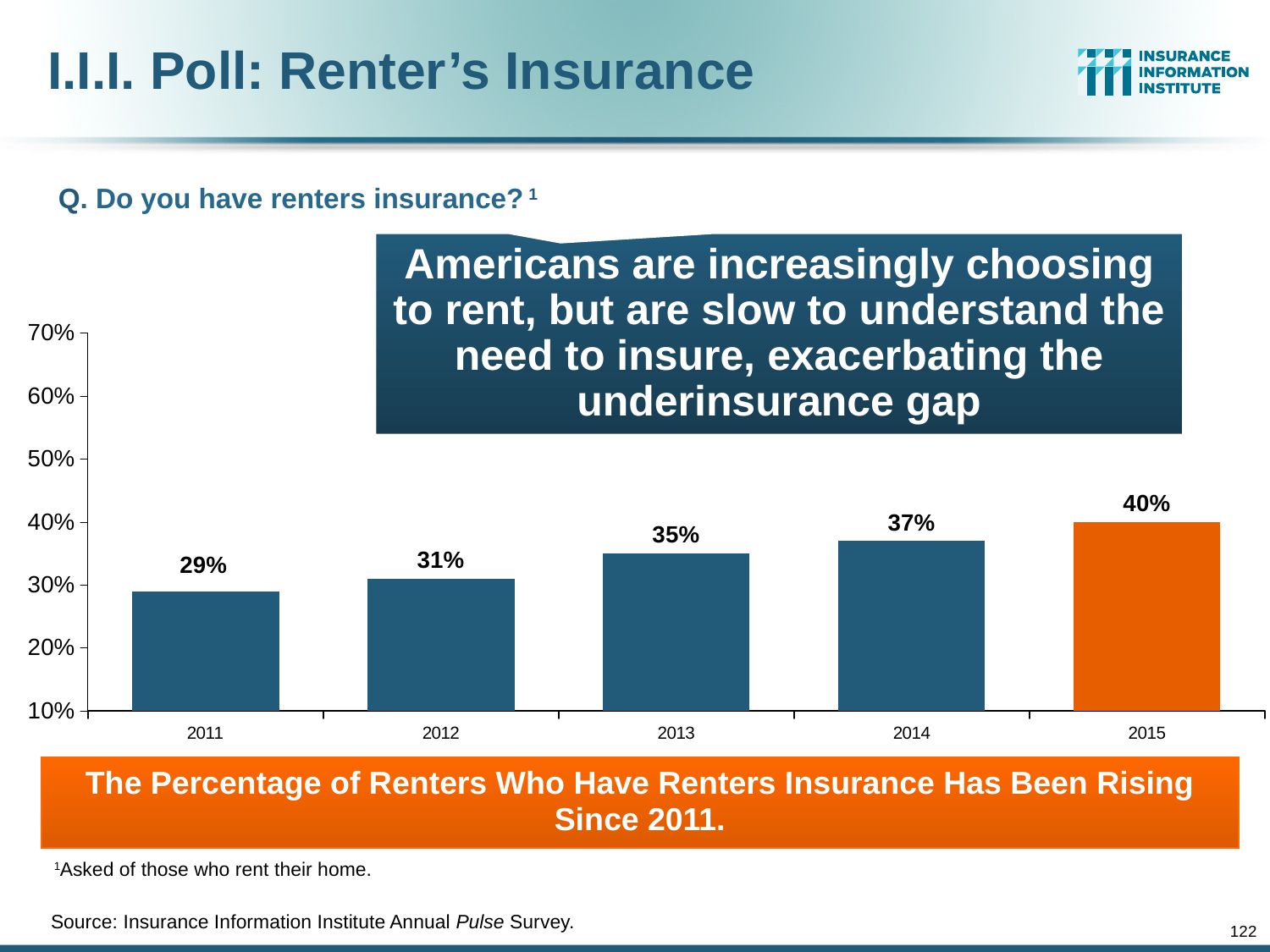
How many years are shown on the chart? 5 What is the value shown for 2015? 40% What percentage of renters had renters insurance in 2011? 29% What is the value shown for 2013? 35% Which year has the highest percentage of renters with renters insurance? 2015 Which year has the lowest percentage of renters with renters insurance? 2011 By how many percentage points did the value increase from 2011 to 2015? 11 percentage points What kind of chart is shown on the slide? Bar chart Which year has a higher value, 2012 or 2014? 2014 Is the value for 2013 greater or less than 30%? greater Do the values rise or fall from 2011 to 2015? Rise What is the difference between the 2014 and 2012 values? 6 percentage points